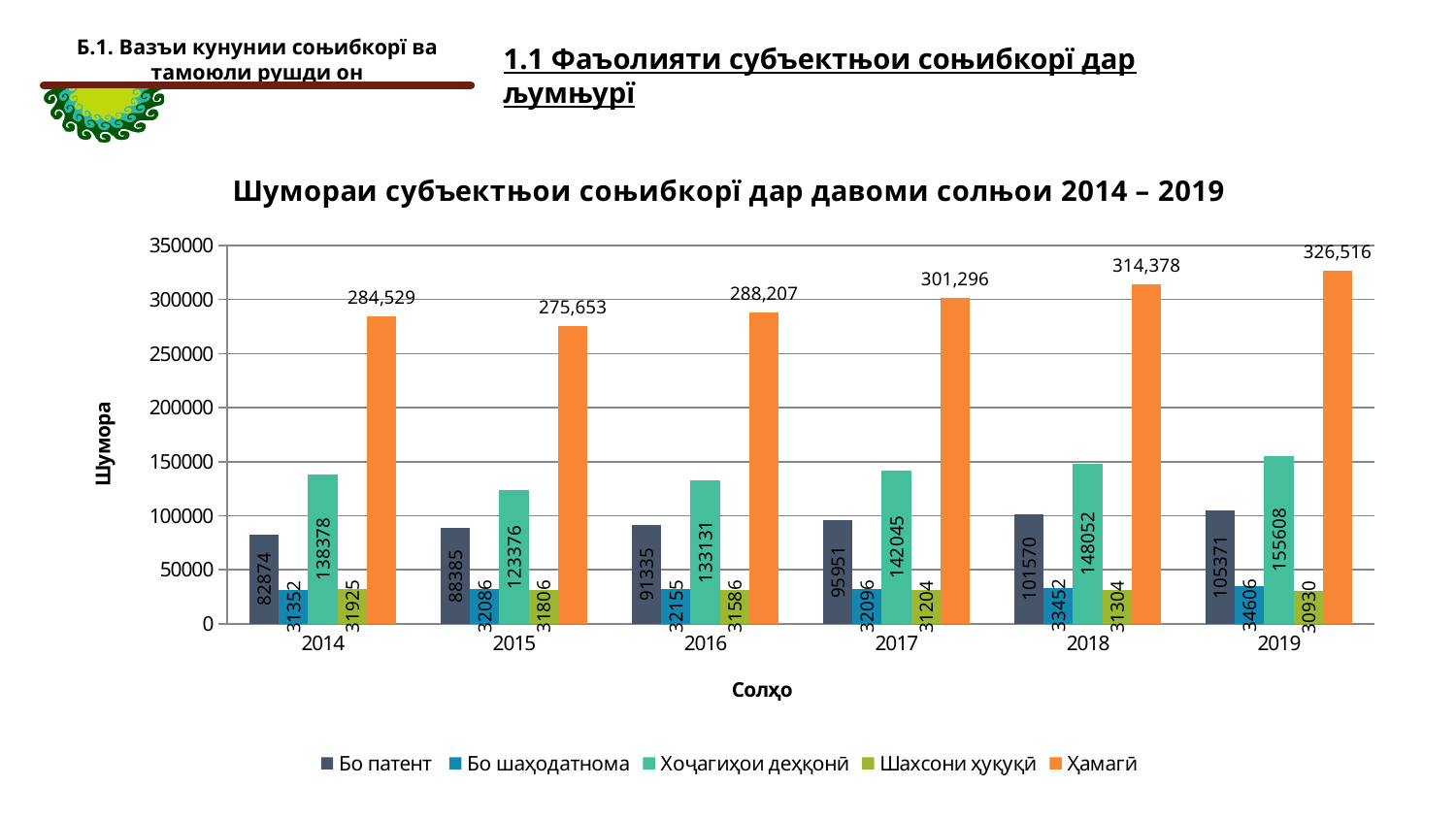
What is the value of Шахсони ҳуқуқӣ for 2019? 30930 What is the value of Бо патент for 2014? 82874 In which year is the Бо патент value the highest? 2019 What type of chart is shown on the slide? bar chart In which year is the Ҳамагӣ value the lowest? 2015 Does the Бо патент value rise or fall from 2014 to 2019? rise How many series does the legend list? 5 What is the value of Ҳамагӣ for 2019? 326,516 What is the value of Хоҷагиҳои деҳқонӣ for 2017? 142045 What is the difference between the Ҳамагӣ values for 2019 and 2018? 12,138 How many years are shown on the x axis? 6 Which is larger: Хоҷагиҳои деҳқонӣ in 2015 or in 2016? 2016